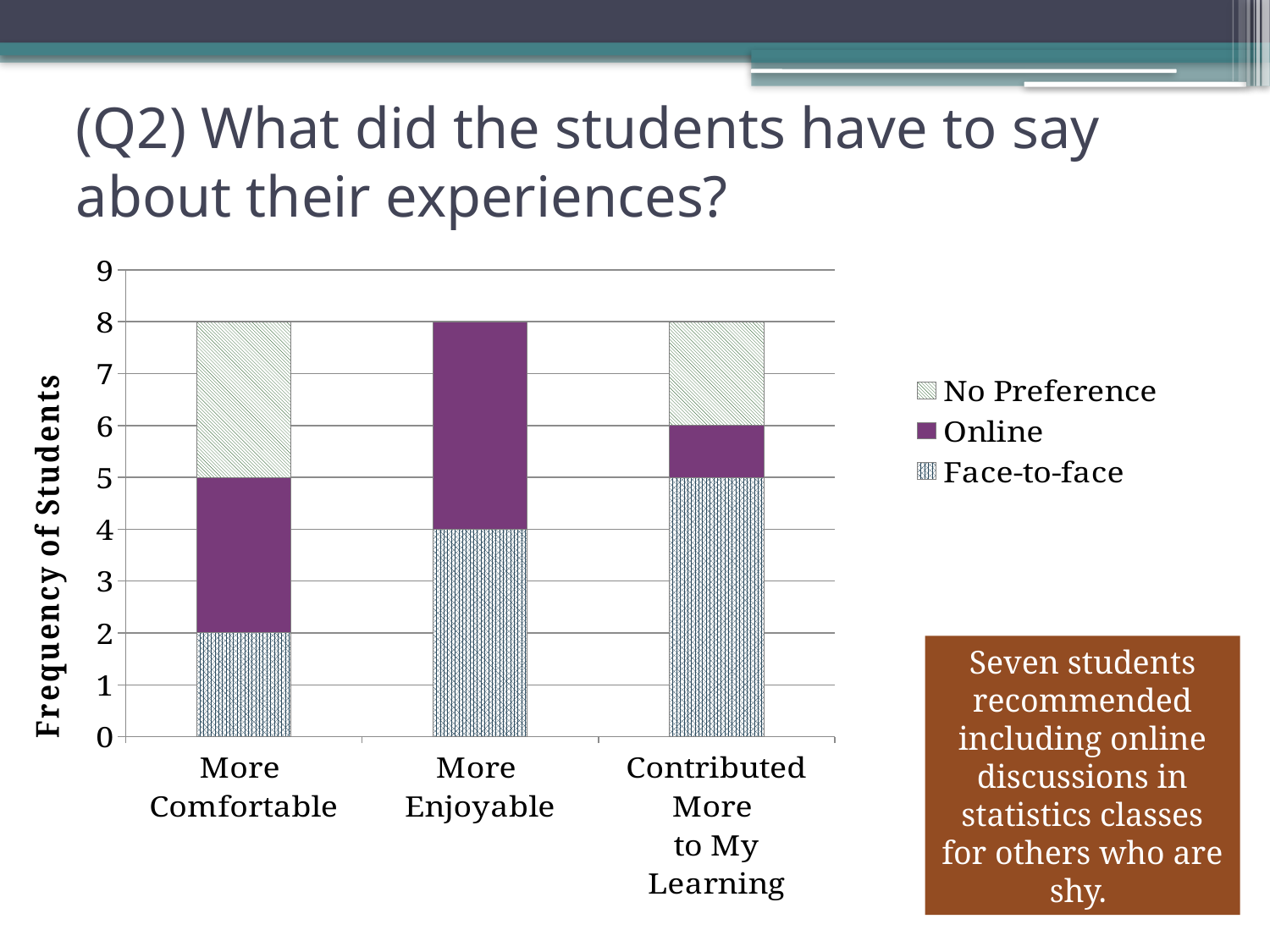
Which category has the highest Face-to-face value? Contributed More to My Learning Which category has the lowest Face-to-face value? More Comfortable What is the Face-to-face value for More Comfortable? 2 What is the Face-to-face value for More Enjoyable? 4 What is the total height of the stacked bar for More Enjoyable? 8 What is the Face-to-face value for Contributed More to My Learning? 5 What kind of chart is shown on the slide? Stacked bar chart Is the Face-to-face value for More Enjoyable greater or less than the Face-to-face value for More Comfortable? greater How many series does the legend list? 3 How many categories are shown on the x axis? 3 What is the label of the y axis? Frequency of Students What is the total height of the stacked bar for More Comfortable? 8